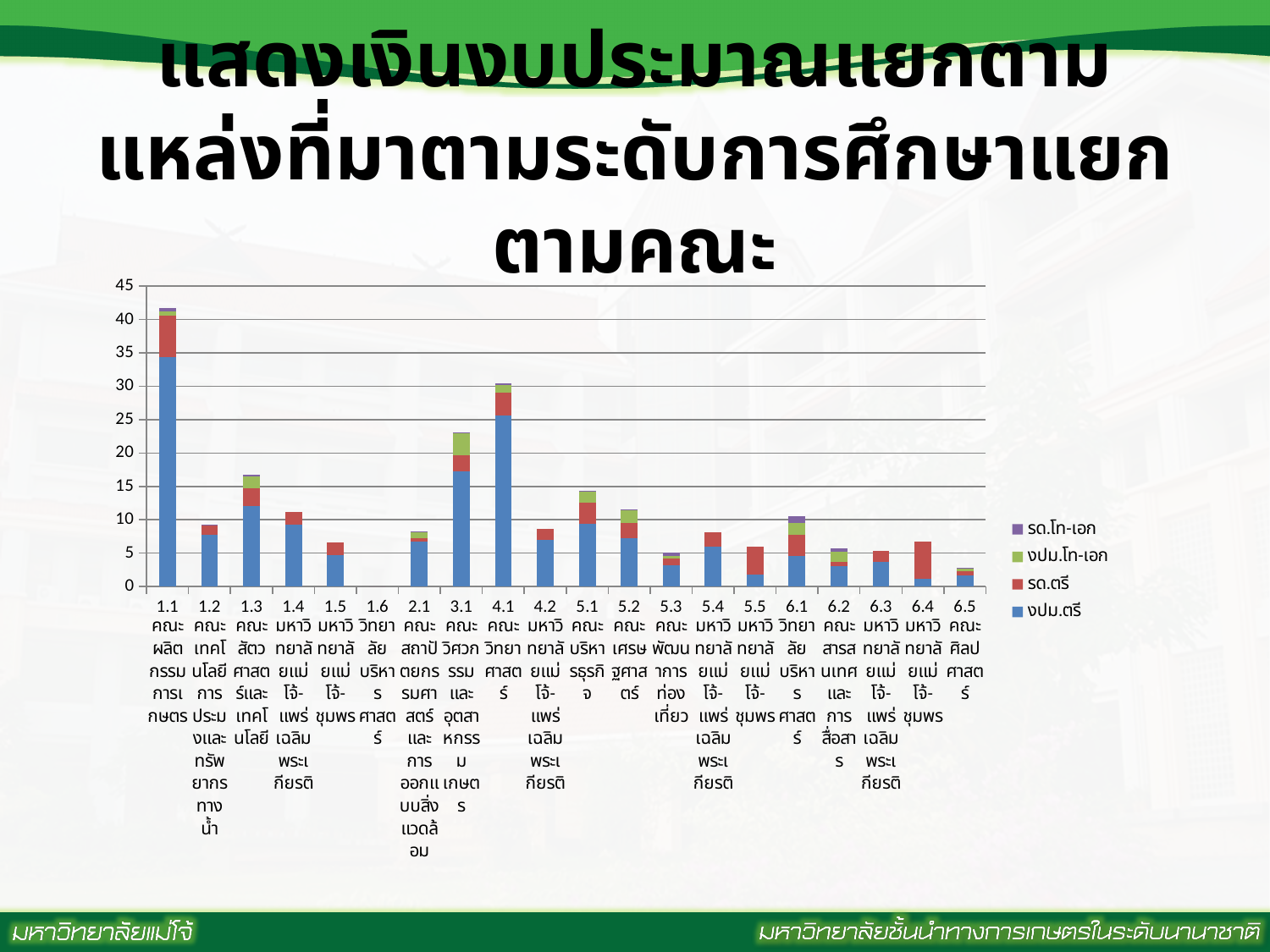
Is the total for category 4.1 greater or less than 25? greater What kind of chart is shown on the slide? stacked bar chart Is the total for category 3.1 greater or less than 20? greater Which has the larger total bar, category 3.1 or category 5.1? 3.1 Is the total for category 6.5 greater or less than 5? less How many categories are shown along the x axis? 20 How many series does the legend list? 4 Which series is shown in blue in the legend? งปม.ตรี Which category has the highest total bar? 1.1 Which has the larger total bar, category 1.3 or category 1.4? 1.3